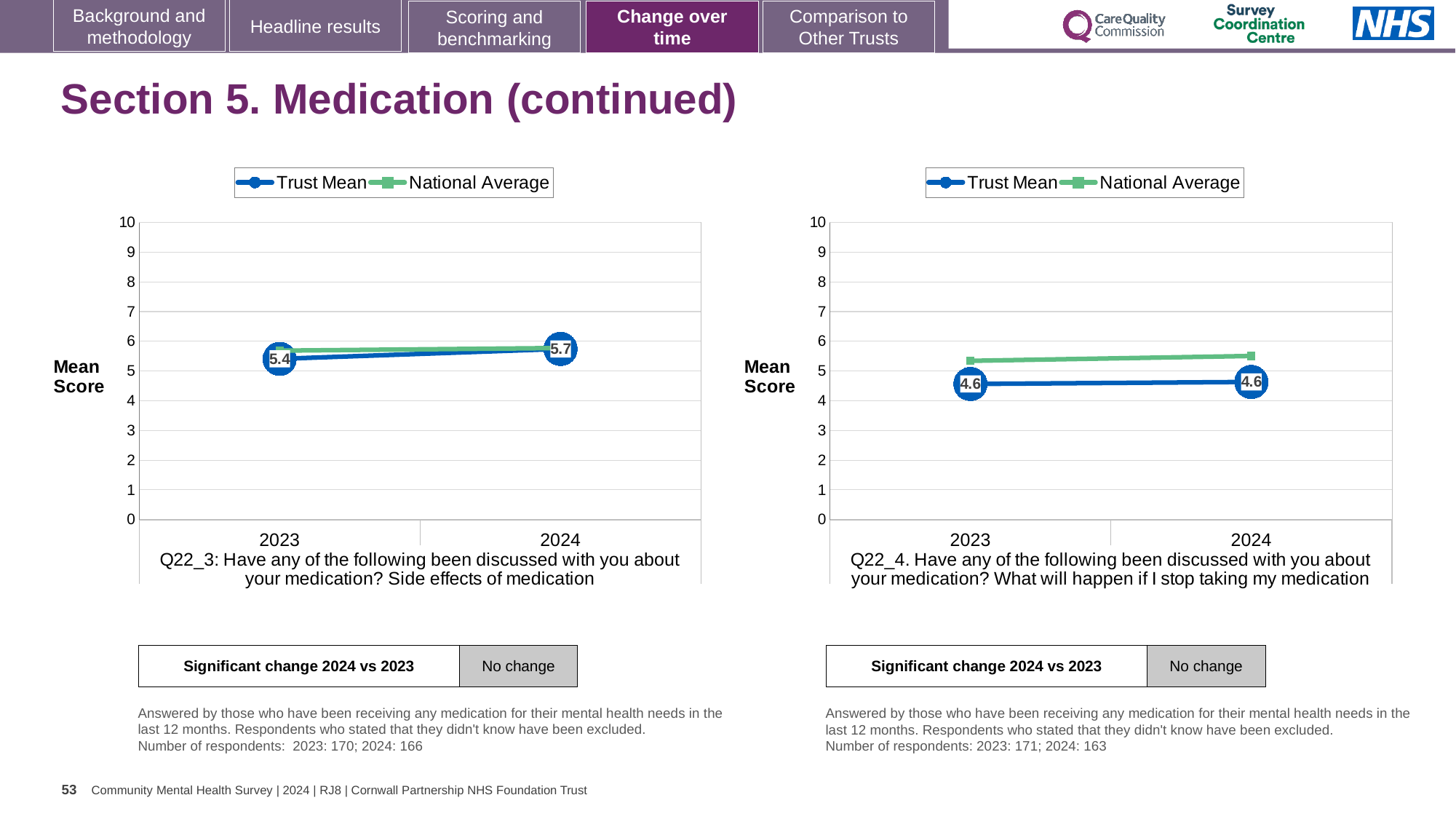
In the right chart (Q22_4), which series has the higher value in 2024, Trust Mean or National Average? National Average In the right chart (Q22_4), does the Trust Mean rise, fall or stay the same from 2023 to 2024? stay the same In the left chart (Q22_3), does the Trust Mean rise or fall from 2023 to 2024? rise In the left chart (Q22_3), what is the Trust Mean score for 2024? 5.7 In the right chart (Q22_4), what is the Trust Mean score for 2024? 4.6 In the left chart (Q22_3), what is the Trust Mean score for 2023? 5.4 How many years are shown on the x axis of the right chart (Q22_4)? 2 In the right chart (Q22_4), is the National Average for 2024 greater or less than 6? less In the right chart (Q22_4), is the National Average for 2023 greater or less than 5? greater In the left chart (Q22_3), by how much did the Trust Mean change from 2023 to 2024? 0.3 What kind of chart is the left chart (Q22_3)? line chart How many series does the legend of the left chart (Q22_3) list? 2